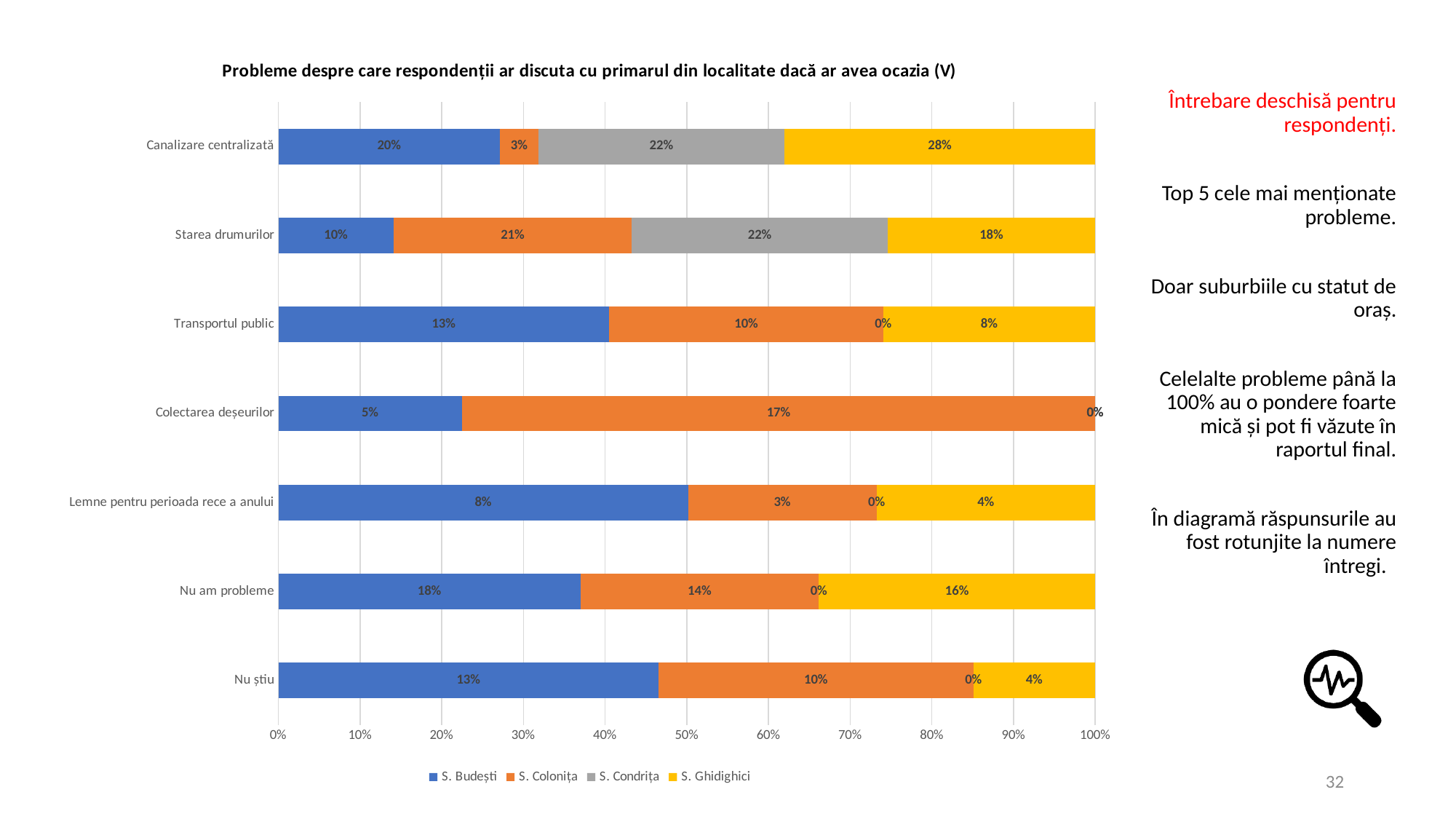
How many categories are shown on the chart? 7 How many series does the legend list? 4 What is the value for S. Condrița in the Starea drumurilor bar? 22% In the Canalizare centralizată bar, what is the difference between the S. Ghidighici value and the S. Budești value? 8% In the Starea drumurilor bar, which is larger: the S. Colonița value or the S. Ghidighici value? S. Colonița What is the title of the chart? Probleme despre care respondenții ar discuta cu primarul din localitate dacă ar avea ocazia (V) What kind of chart is shown on the slide? Stacked bar chart For the S. Budești series, which category has the highest value? Canalizare centralizată What is the value for S. Budești in the Nu am probleme bar? 18% For the S. Budești series, which category has the lowest value? Colectarea deșeurilor What is the value for S. Ghidighici in the Canalizare centralizată bar? 28% What is the value for S. Colonița in the Starea drumurilor bar? 21%